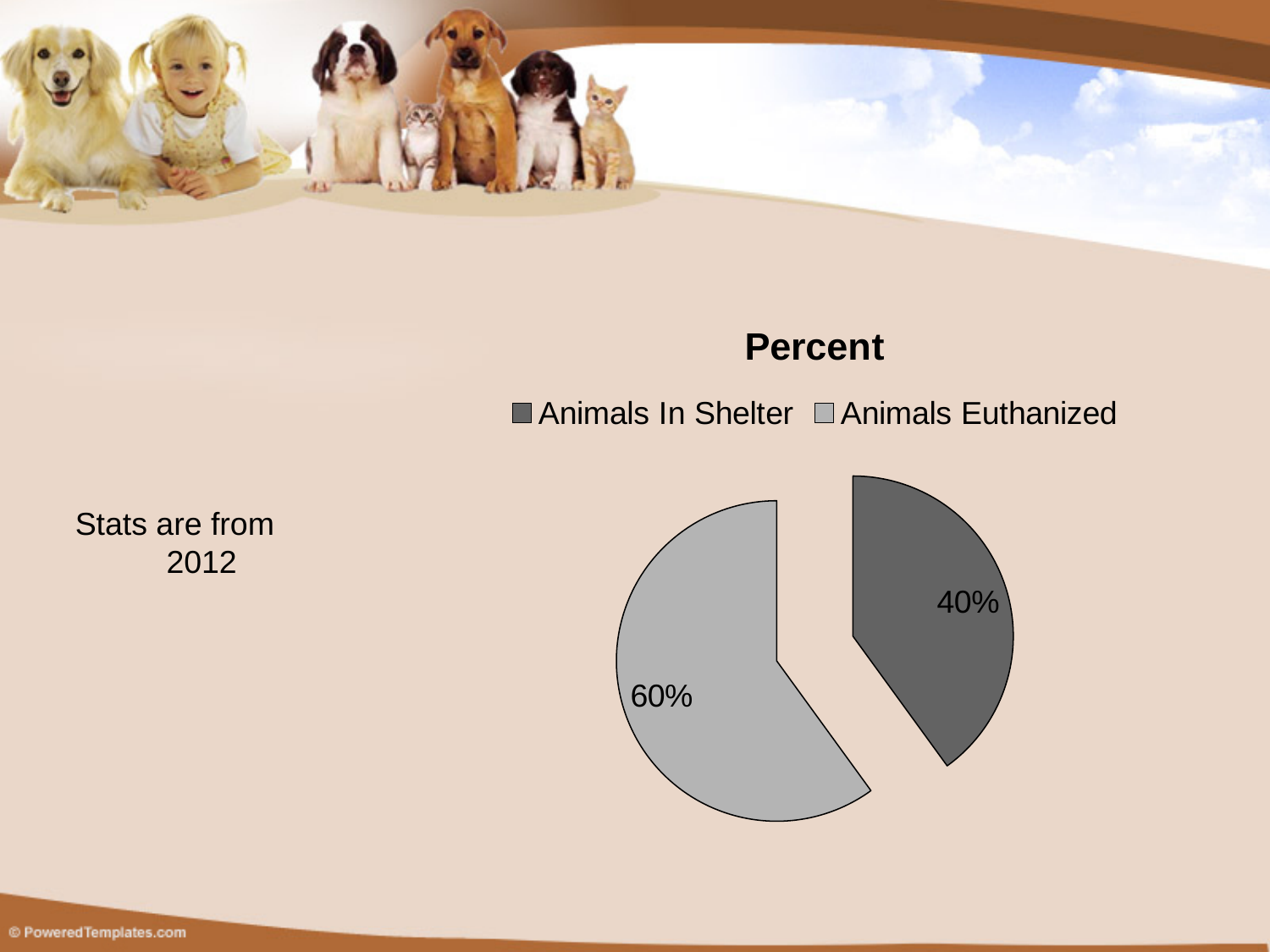
What type of chart is shown on the slide? pie chart What percentage is shown for Animals In Shelter? 40% How many entries does the legend list? 2 How many slices does the pie chart have? 2 Which is larger, Animals In Shelter or Animals Euthanized? Animals Euthanized Which legend entry is shown in the darker grey colour? Animals In Shelter What is the title of the chart? Percent What percentage is shown for Animals Euthanized? 60% What share of the pie does Animals Euthanized represent? 60% What is the difference between the Animals Euthanized and Animals In Shelter percentages? 20% Which slice is the smallest? Animals In Shelter Which slice is the largest? Animals Euthanized